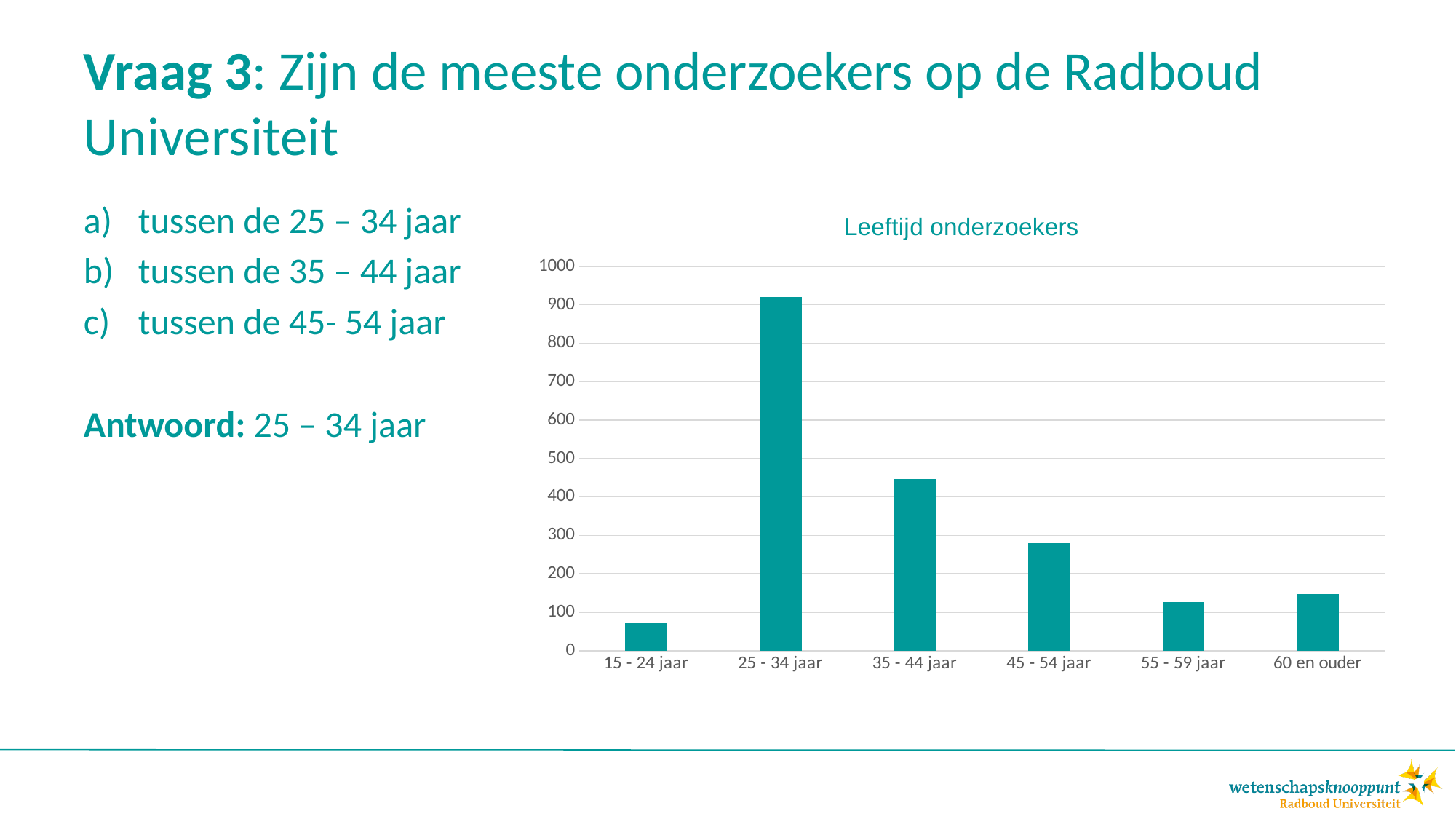
Is the value for 45 - 54 jaar greater or less than 200? greater Which age category has the highest bar in the chart? 25 - 34 jaar How many age categories are shown on the x axis of the chart? 6 Is the value for 35 - 44 jaar greater or less than 500? less What type of chart is shown on the slide? bar chart Is the value for 25 - 34 jaar greater or less than 900? greater Which has a larger value, 35 - 44 jaar or 45 - 54 jaar? 35 - 44 jaar Which has a larger value, 15 - 24 jaar or 55 - 59 jaar? 55 - 59 jaar What is the title of the chart? Leeftijd onderzoekers Which age category has the lowest bar in the chart? 15 - 24 jaar